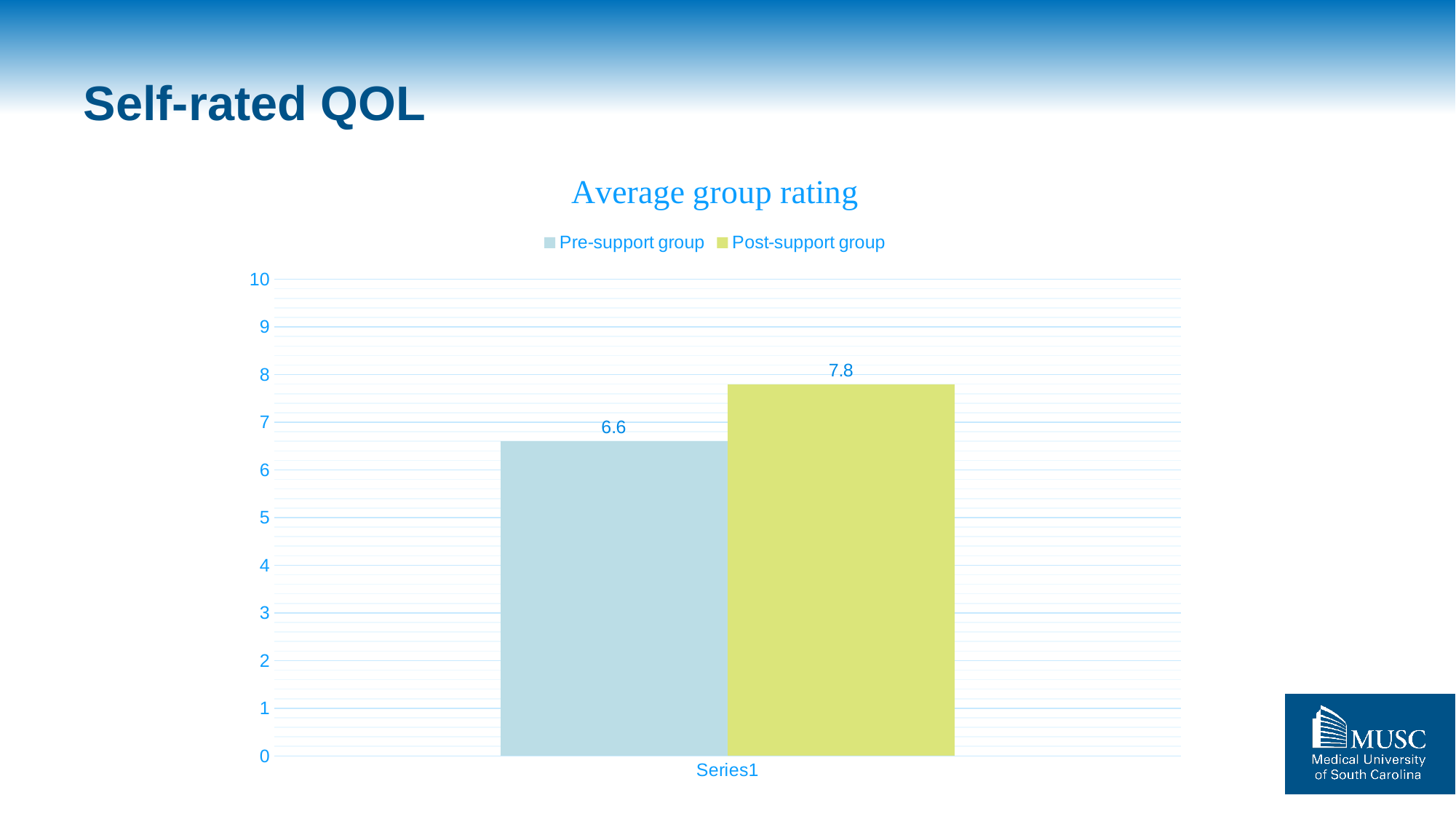
What is the value for the Pre-support group? 6.6 What kind of chart is shown on the slide? bar chart What is the value for the Post-support group? 7.8 Is the value for the Post-support group greater or less than 7? greater What is the label on the horizontal axis under the bars? Series1 How many series does the legend list? 2 What is the title of the chart? Average group rating What is the difference between the Post-support group and Pre-support group values? 1.2 Which series has the lower value? Pre-support group Is the value for the Pre-support group greater or less than 7? less What is the maximum value shown on the vertical axis? 10 Which series has the higher value, Pre-support group or Post-support group? Post-support group